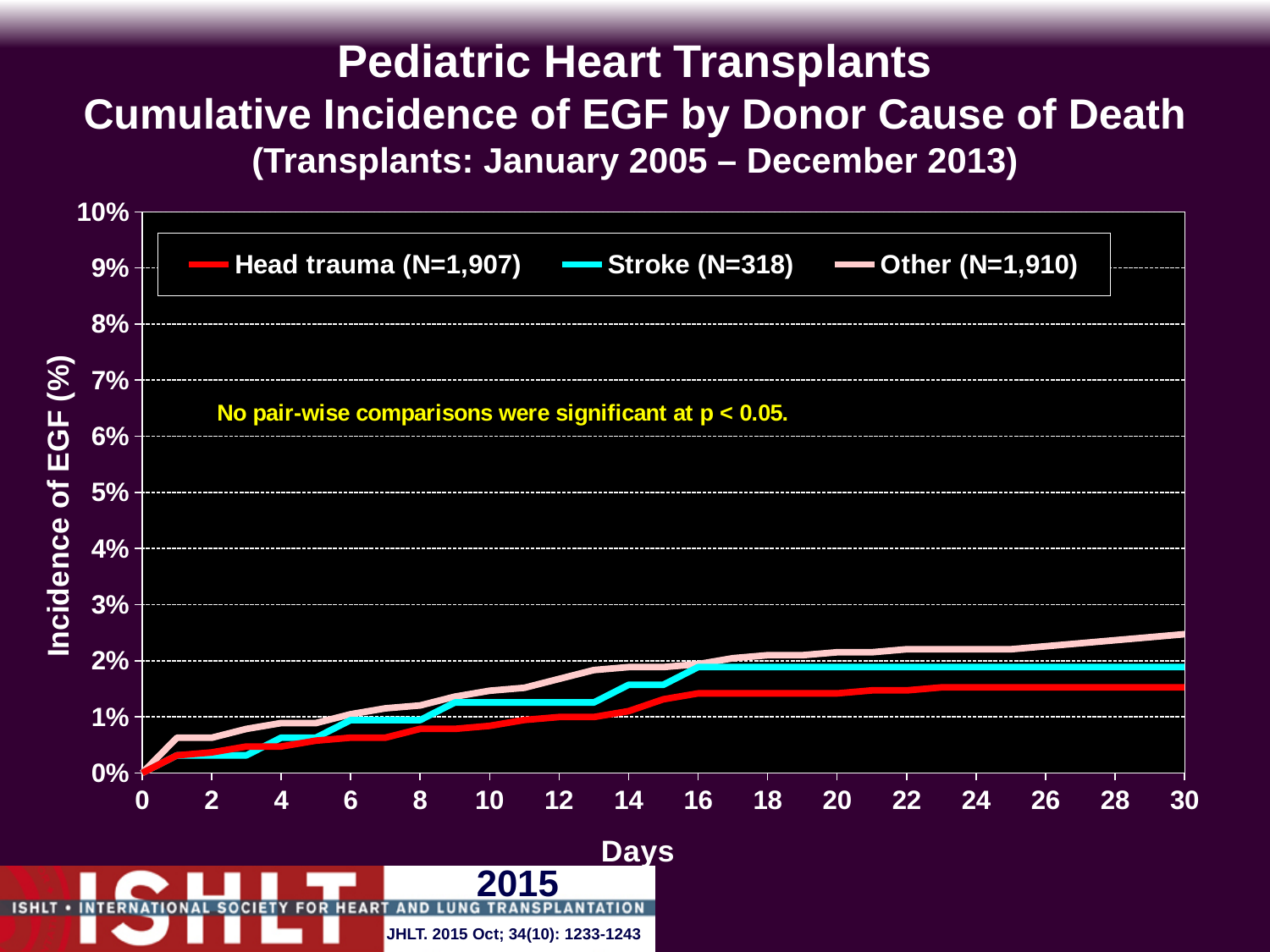
At day 30, is the cumulative incidence of EGF higher for Stroke or for Head trauma? Stroke Do the cumulative incidence values rise or fall as the number of days increases? rise What kind of chart is shown on the slide? line chart Which series has the lowest cumulative incidence of EGF at day 30? Head trauma (N=1,907) What does the yellow annotation on the chart say about pair-wise comparisons? No pair-wise comparisons were significant at p < 0.05. Is the value for Head trauma at day 30 greater or less than 2%? less How many series does the legend list? 3 Is the value for Head trauma at day 10 greater or less than 1%? less Is the value for Other at day 30 greater or less than 2%? greater Which series has the highest cumulative incidence of EGF at day 30? Other (N=1,910) What is the N for the Stroke series shown in the legend? N=318